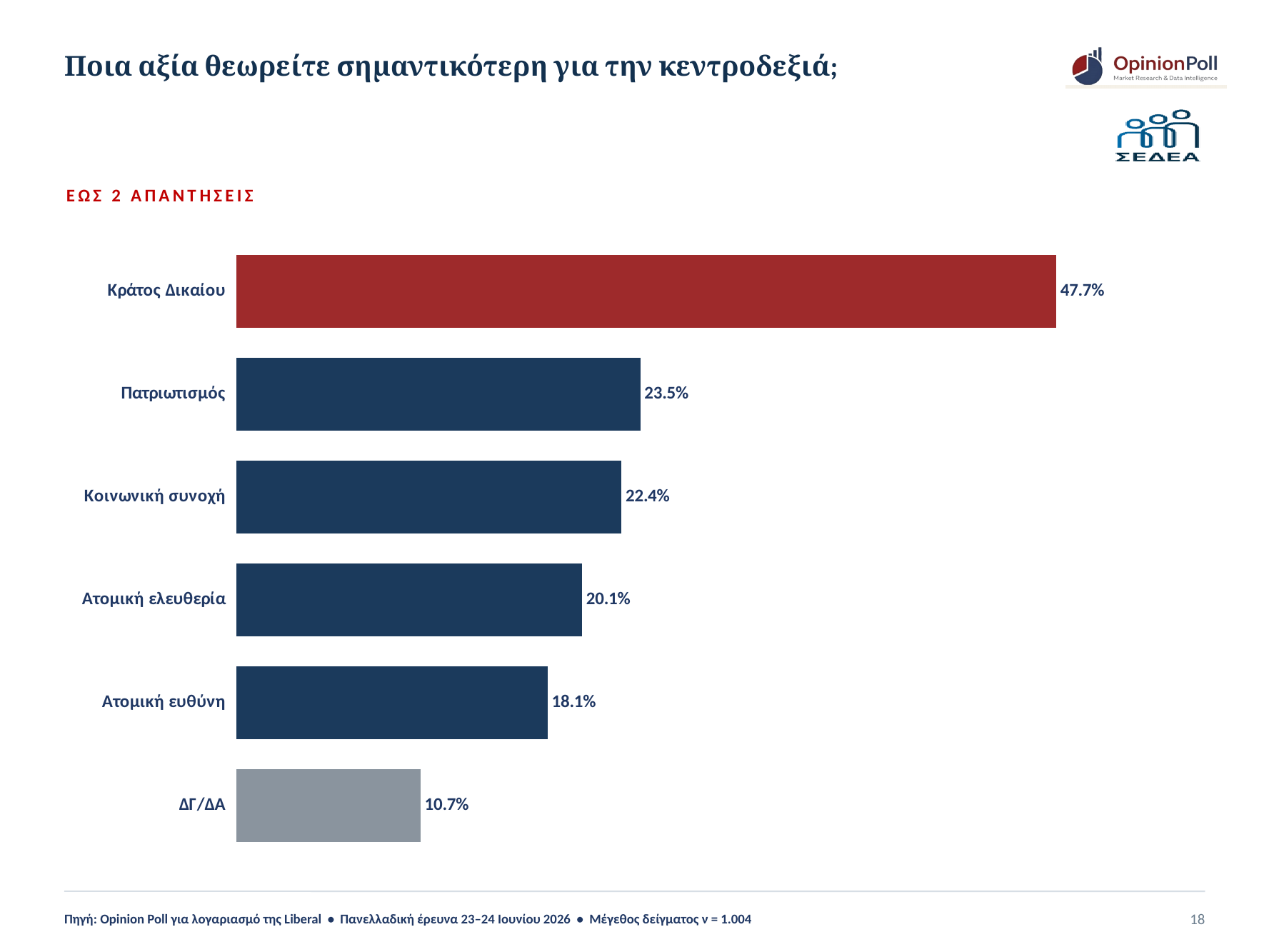
Which is larger, the value for Πατριωτισμός or the value for Ατομική ελευθερία? Πατριωτισμός What is the difference between the values for Ατομική ελευθερία and Ατομική ευθύνη? 2.0% What is the value for Ατομική ευθύνη? 18.1% Which bar is coloured red? Κράτος Δικαίου What is the difference between the values for Κράτος Δικαίου and Πατριωτισμός? 24.2% Which category has the lowest value? ΔΓ/ΔΑ What is the value for Κράτος Δικαίου? 47.7% How many categories are shown in the chart? 6 What is the value for Πατριωτισμός? 23.5% Which category has the highest value? Κράτος Δικαίου What kind of chart is shown on the slide? Bar chart What is the value for Κοινωνική συνοχή? 22.4%